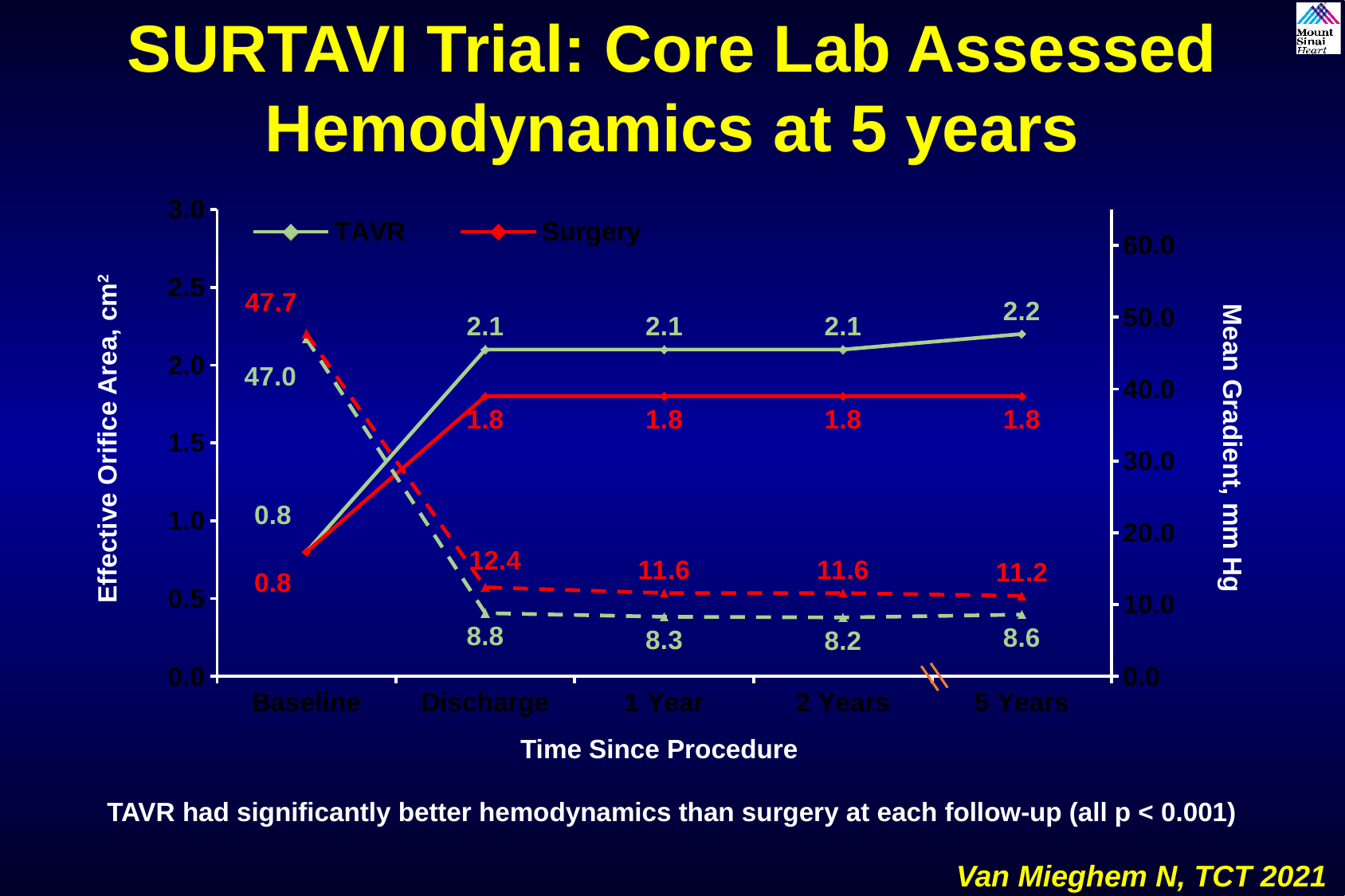
What type of chart is shown on the slide? Line chart What is the label of the right-hand y axis? Mean Gradient, mm Hg What is the TAVR effective orifice area at 5 Years? 2.2 What is the Surgery mean gradient at Baseline? 47.7 What is the Surgery effective orifice area at Discharge? 1.8 At which time point is the TAVR mean gradient lowest? 2 Years What is the difference between the Surgery and TAVR mean gradients at Discharge? 3.6 How many series does the legend list? 2 What is the TAVR mean gradient at 2 Years? 8.2 At 1 Year, which group has the larger effective orifice area, TAVR or Surgery? TAVR Does the TAVR mean gradient rise or fall from Baseline to Discharge? Fall How many time points are shown on the x axis? 5